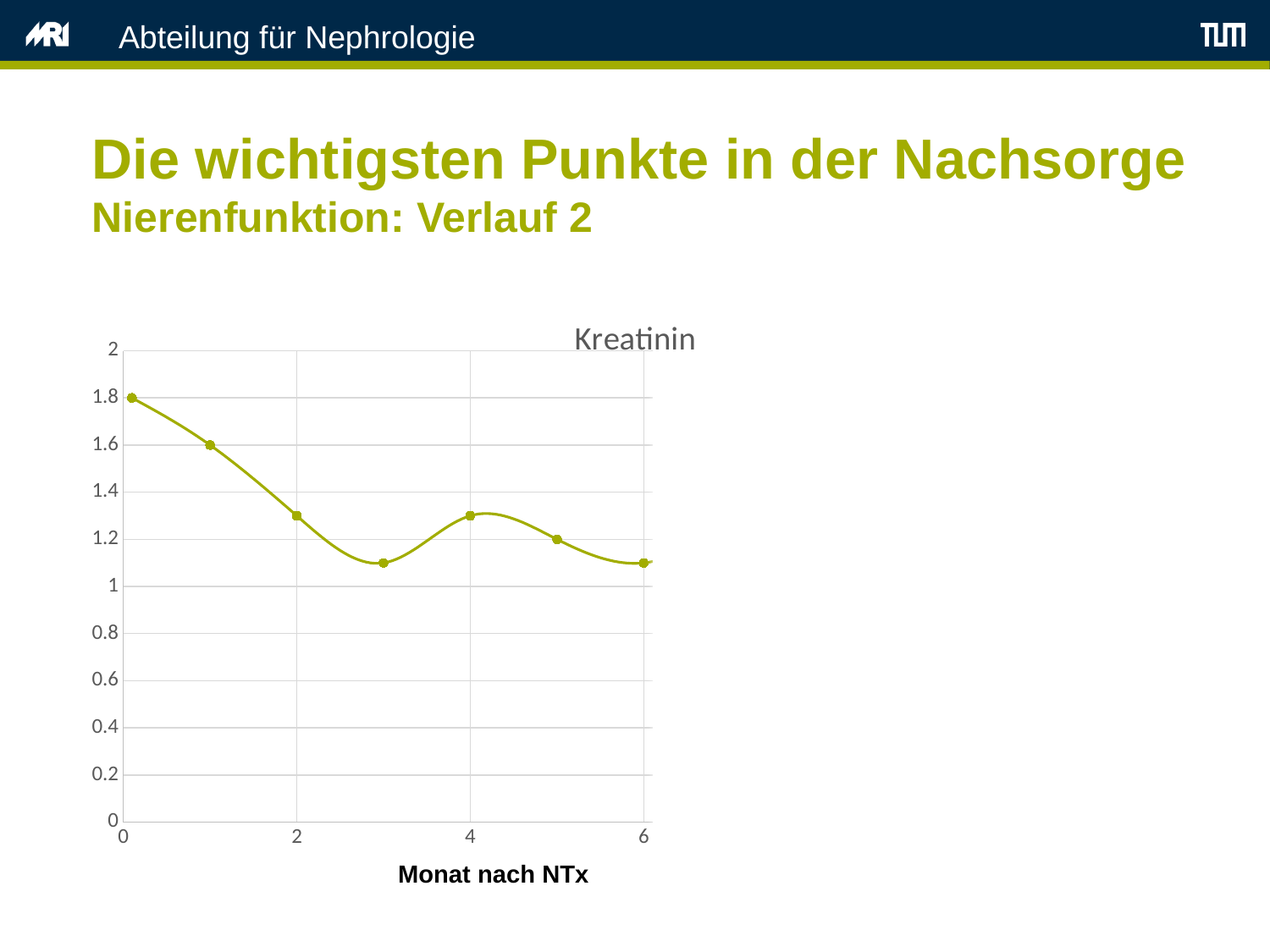
What is the difference between the Kreatinin values at month 0 and month 1? 0.2 What is the chart title? Kreatinin Is the Kreatinin value at month 3 greater or less than 1? greater How many data points are plotted on the line? 7 At which month after NTx is the Kreatinin value highest? 0 What is the Kreatinin value at month 0 after NTx? 1.8 What kind of chart is shown? line chart What is the label of the x axis? Monat nach NTx Which is larger, the Kreatinin value at month 1 or at month 4? month 1 What is the Kreatinin value at month 1 after NTx? 1.6 Is the Kreatinin value at month 2 greater or less than 1.4? less Does the Kreatinin value overall rise or fall from month 0 to month 6? fall